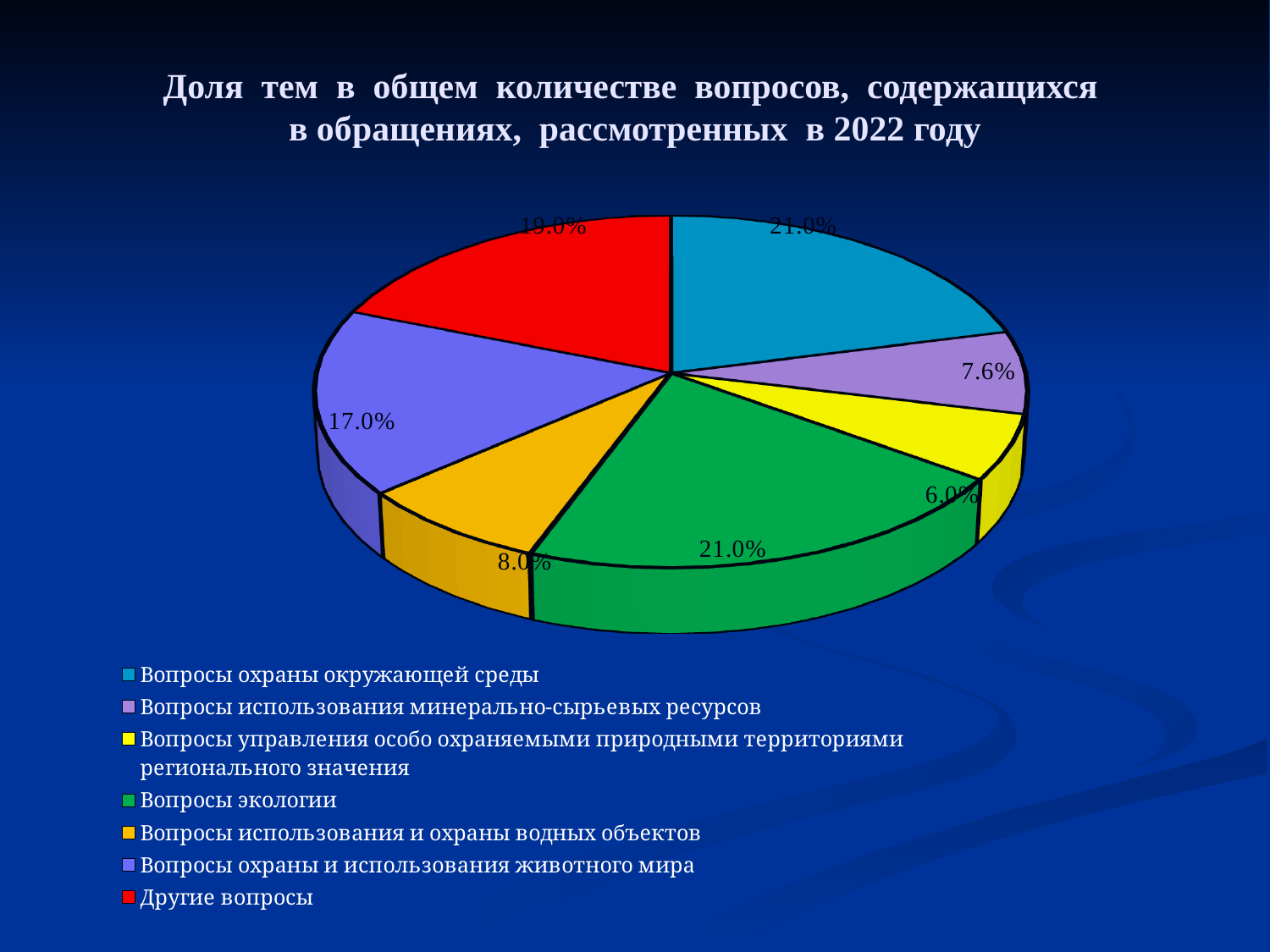
What colour is the slice for "Вопросы экологии"? Green What share of the pie is labelled for "Вопросы экологии"? 21.0% Which category has the smallest share of the pie? Вопросы управления особо охраняемыми природными территориями регионального значения What share of the pie is labelled for "Вопросы охраны окружающей среды"? 21.0% What is the difference between the share for "Вопросы использования и охраны водных объектов" and the share for "Вопросы управления особо охраняемыми природными территориями регионального значения"? 2.0% What share of the pie is labelled for "Вопросы использования минерально-сырьевых ресурсов"? 7.6% How many slices does the pie chart have? 7 What share of the pie is labelled for "Вопросы использования и охраны водных объектов"? 8.0% What share of the pie is labelled for "Другие вопросы"? 19.0% What kind of chart is shown on the slide? Pie chart What share of the pie is labelled for "Вопросы охраны и использования животного мира"? 17.0% Which is larger: the share for "Другие вопросы" or the share for "Вопросы охраны и использования животного мира"? Другие вопросы